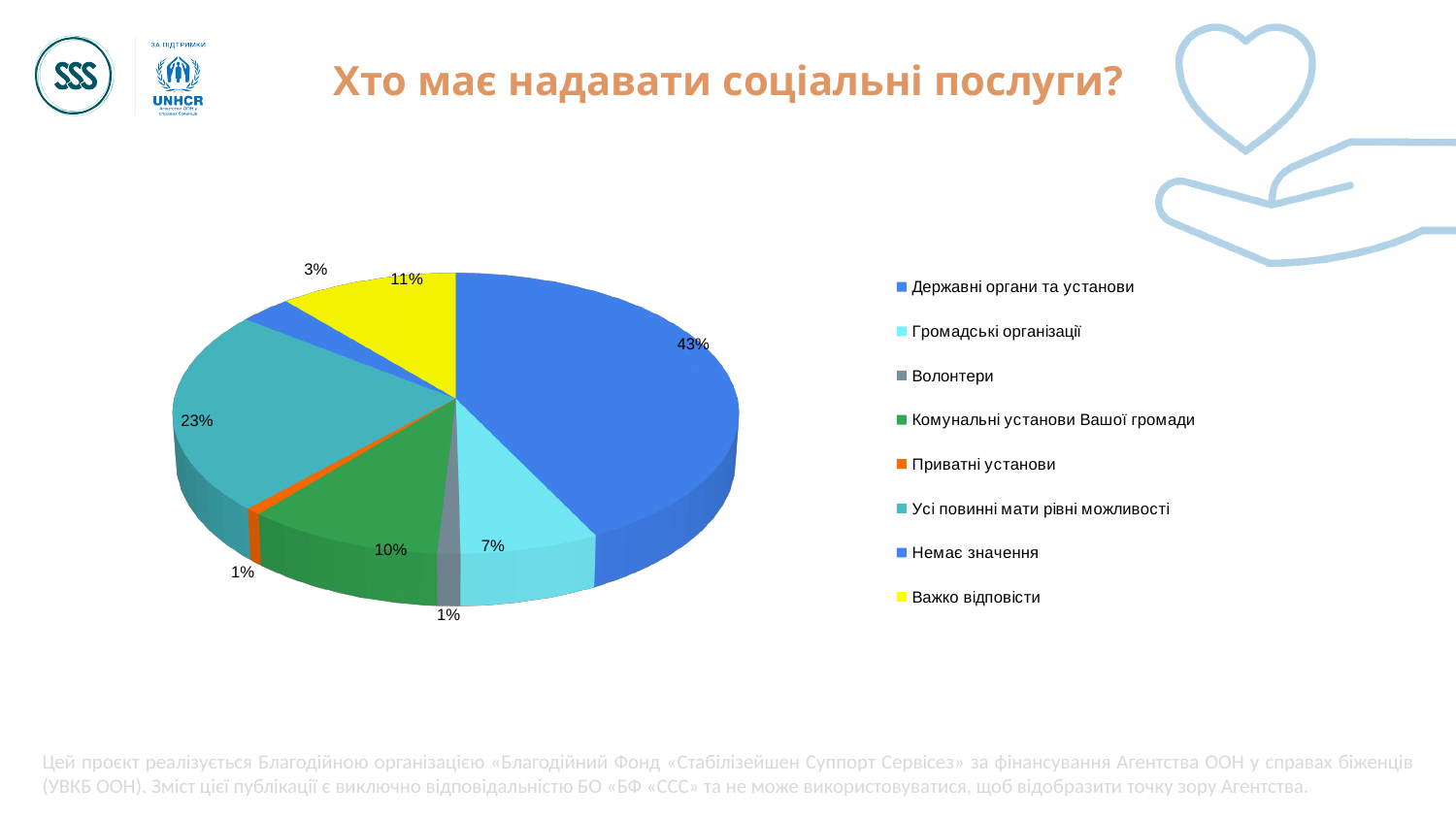
What kind of chart is shown on the slide? pie chart Which has a larger share: "Важко відповісти" or "Комунальні установи Вашої громади"? Важко відповісти What share of the pie does "Комунальні установи Вашої громади" have? 10% What is the title of the chart on the slide? Хто має надавати соціальні послуги? What share of the pie does "Державні органи та установи" have? 43% What share of the pie does "Громадські організації" have? 7% Which category has the largest share of the pie? Державні органи та установи What share of the pie does "Немає значення" have? 3% How many categories does the legend list? 8 What share of the pie does "Усі повинні мати рівні можливості" have? 23% What share of the pie does "Важко відповісти" have? 11% What is the difference between the shares of "Державні органи та установи" and "Усі повинні мати рівні можливості"? 20%